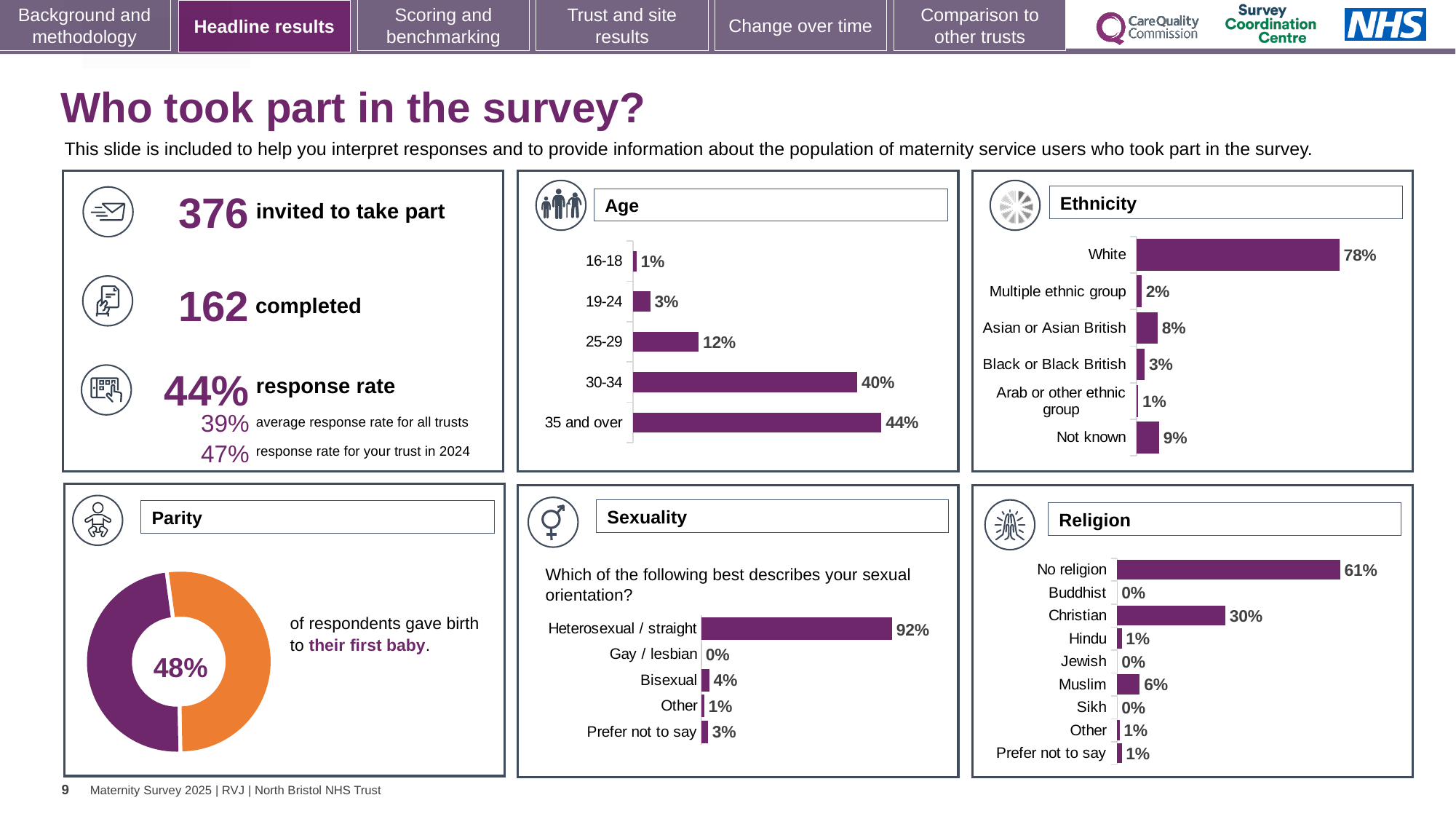
In the Ethnicity chart, which is larger: Not known or Multiple ethnic group? Not known In the Age chart, what percentage of respondents were aged 30-34? 40% In the Sexuality chart, what percentage of respondents answered Heterosexual / straight? 92% In the Sexuality chart, what is the difference between Bisexual and Prefer not to say? 1% In the Religion chart, what percentage of respondents were Christian? 30% In the Religion chart, how many religion categories are listed? 9 In the Age chart, which age group has the highest percentage? 35 and over In the Age chart, how many age categories are shown? 5 What kind of chart is the Parity chart? Doughnut chart In the Ethnicity chart, what is the difference between the percentages for Asian or Asian British and Black or Black British? 5% In the Ethnicity chart, what percentage of respondents were White? 78% In the Parity chart, what percentage of respondents gave birth to their first baby? 48%